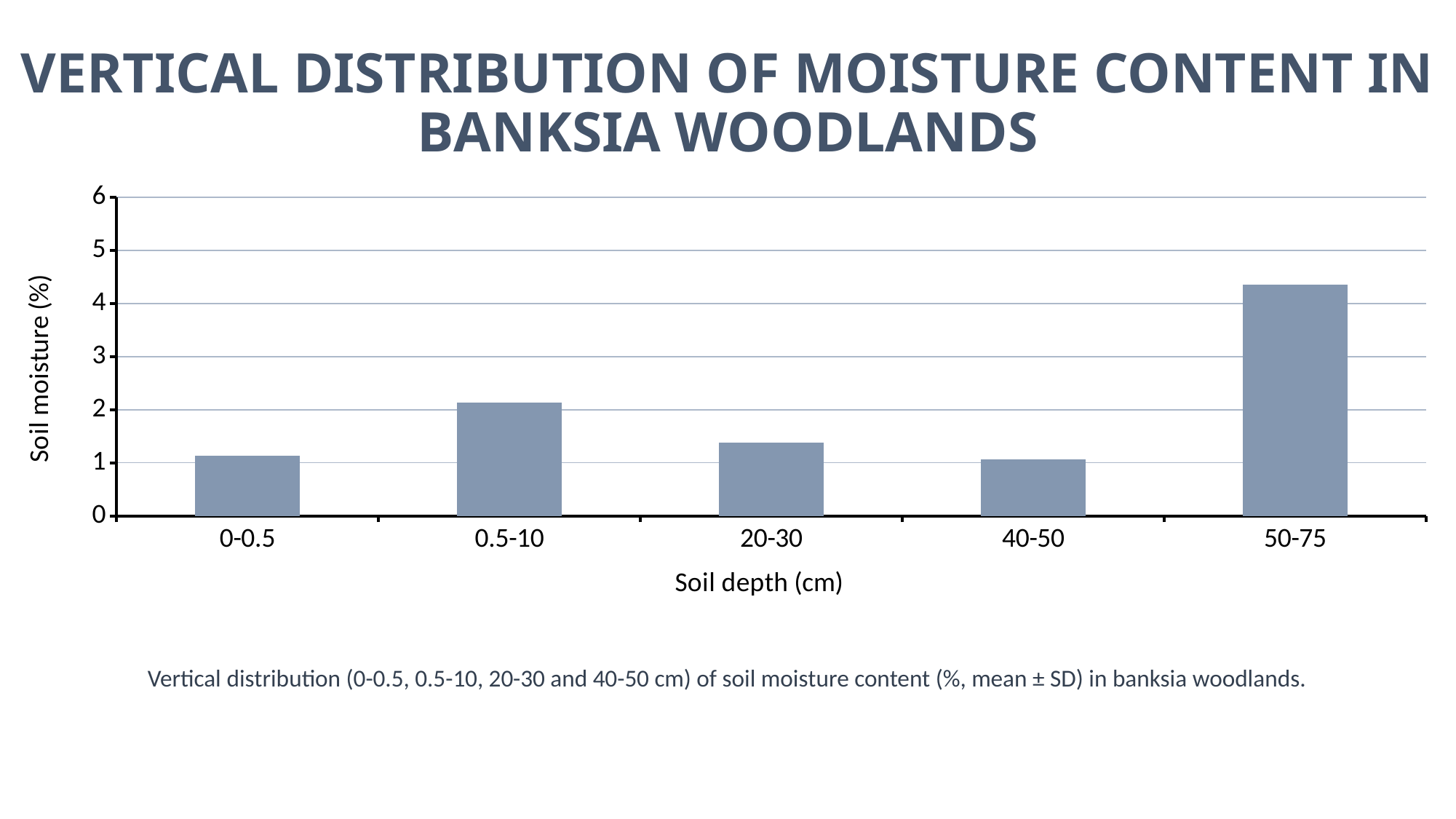
Is the soil moisture for the 0.5-10 cm depth greater or less than 2? greater What is the label of the x axis? Soil depth (cm) What is the label of the y axis? Soil moisture (%) Which has higher soil moisture, the 50-75 cm depth or the 0.5-10 cm depth? 50-75 How many soil depth categories are shown on the chart? 5 Is the soil moisture for the 20-30 cm depth greater or less than 2? less Is the soil moisture for the 40-50 cm depth greater or less than 2? less What kind of chart is shown on the slide? bar chart Which soil depth has the highest soil moisture? 50-75 Which has higher soil moisture, the 0.5-10 cm depth or the 20-30 cm depth? 0.5-10